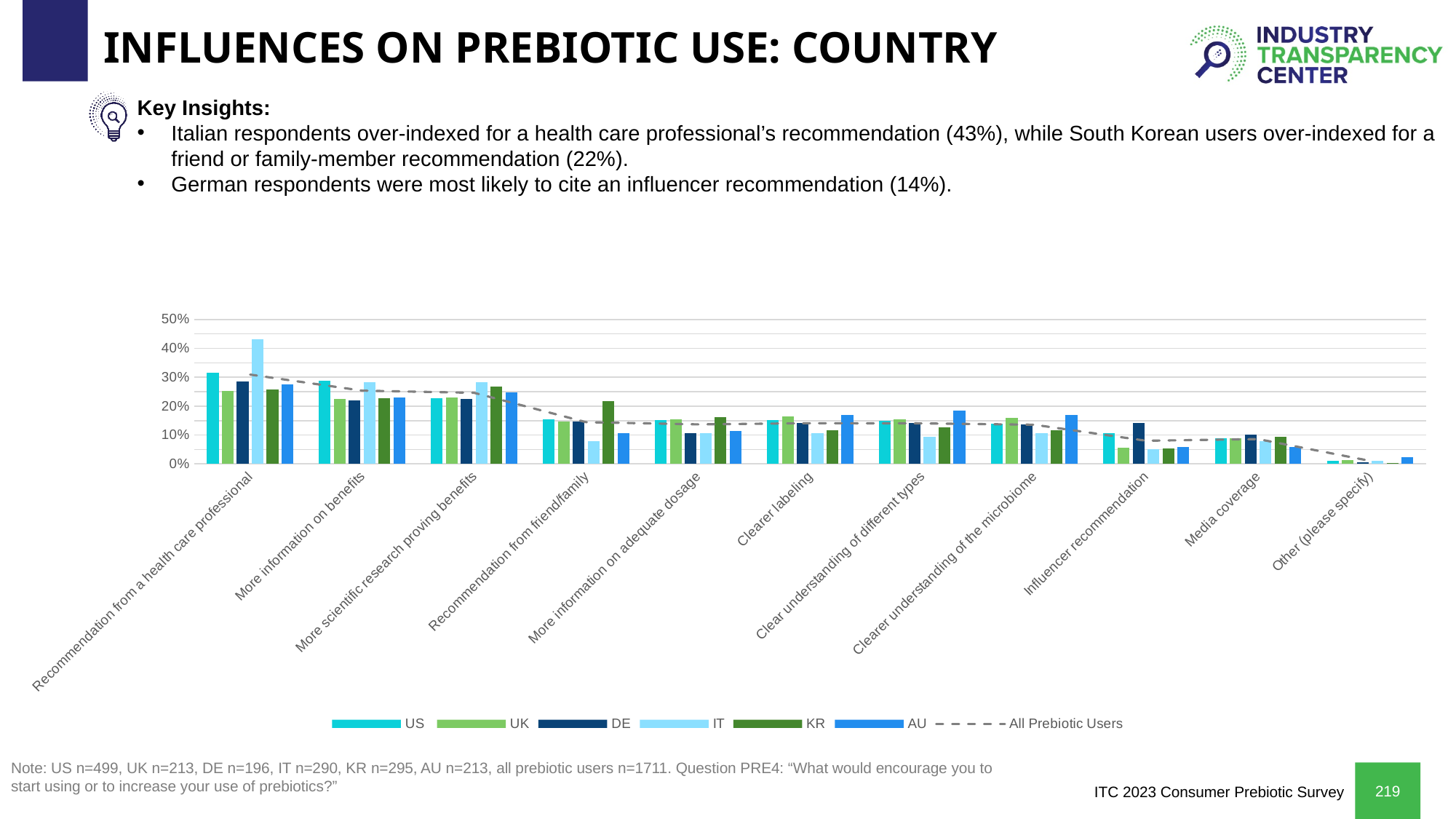
How many series does the chart legend list? 7 How many categories are shown along the x axis of the chart? 11 Does the dashed 'All Prebiotic Users' line rise or fall from left to right along the x axis? fall What type of chart is shown on the slide? combination bar and line chart Which is larger for 'Recommendation from friend/family': the KR bar or the IT bar? KR Which category has the lowest values across all countries? Other (please specify) Is the KR value for 'Recommendation from friend/family' greater or less than 20%? greater Is the IT value for 'Recommendation from a health care professional' greater or less than 40%? greater Is the IT value for 'Recommendation from friend/family' greater or less than 10%? less Which country has the highest bar for 'Recommendation from a health care professional'? IT Which series is represented by the dashed grey line in the chart? All Prebiotic Users